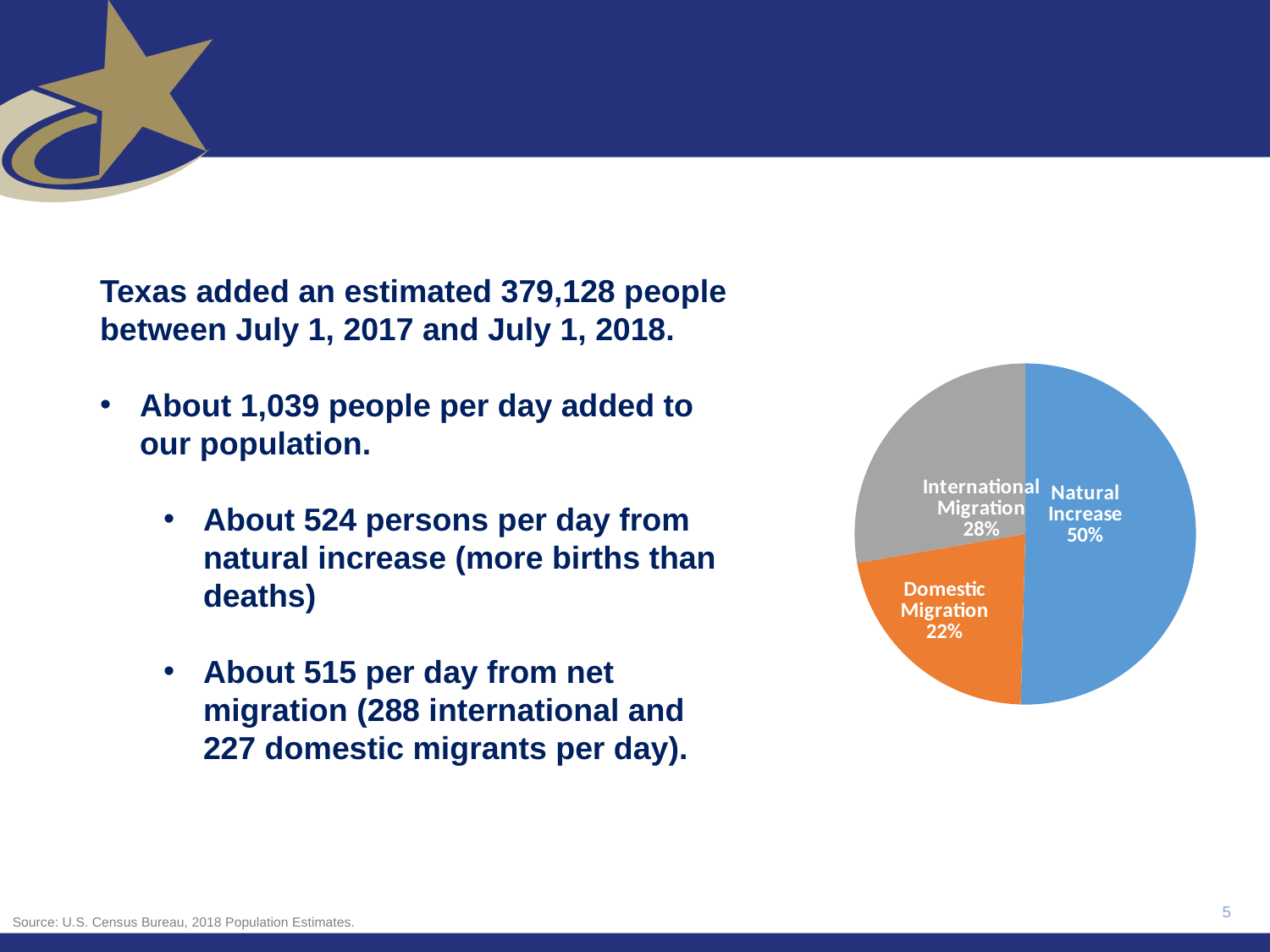
What colour is the Domestic Migration slice of the pie chart? Orange What share of the pie chart is Domestic Migration? 22% What is the difference in percentage points between the International Migration and Domestic Migration slices? 6 Which slice of the pie chart is the largest? Natural Increase What share of the pie chart is Natural Increase? 50% What share of the pie chart is International Migration? 28% Which is larger in the pie chart, International Migration or Domestic Migration? International Migration Which slice of the pie chart is the smallest? Domestic Migration What kind of chart is shown on the slide? Pie chart What is the difference in percentage points between the Natural Increase and International Migration slices? 22 How many slices does the pie chart have? 3 What colour is the Natural Increase slice of the pie chart? Blue